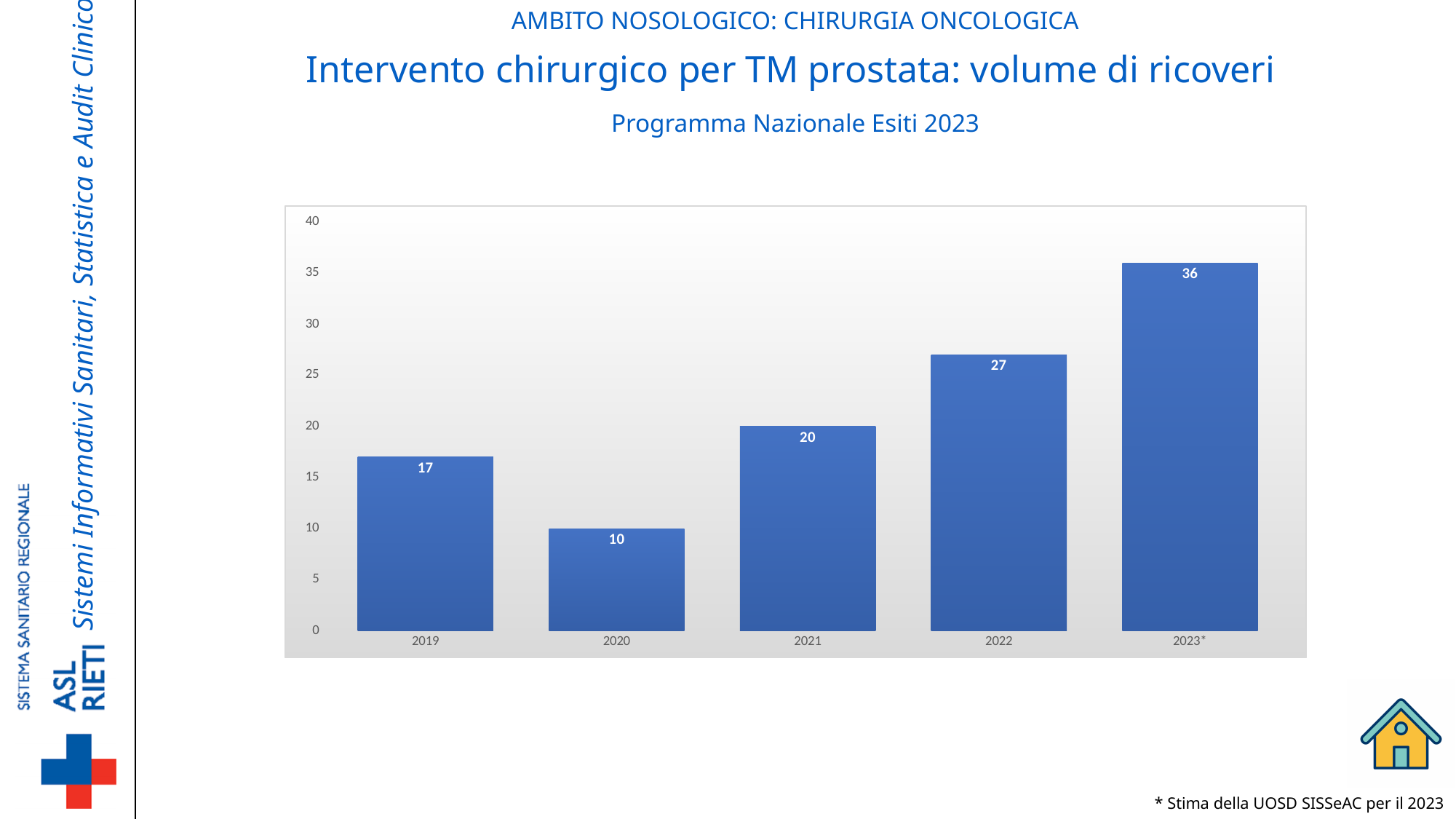
What is the value for 2023*? 36 Which is larger, the value for 2019 or the value for 2021? 2021 What is the value for 2019? 17 How many years are shown on the x axis? 5 What kind of chart is shown on the slide? Bar chart What is the value for 2022? 27 Do the values rise or fall from 2020 to 2023*? Rise Which year has the highest value? 2023* What is the value for 2020? 10 What is the value for 2021? 20 Which year has the lowest value? 2020 What is the difference between the values for 2023* and 2022? 9